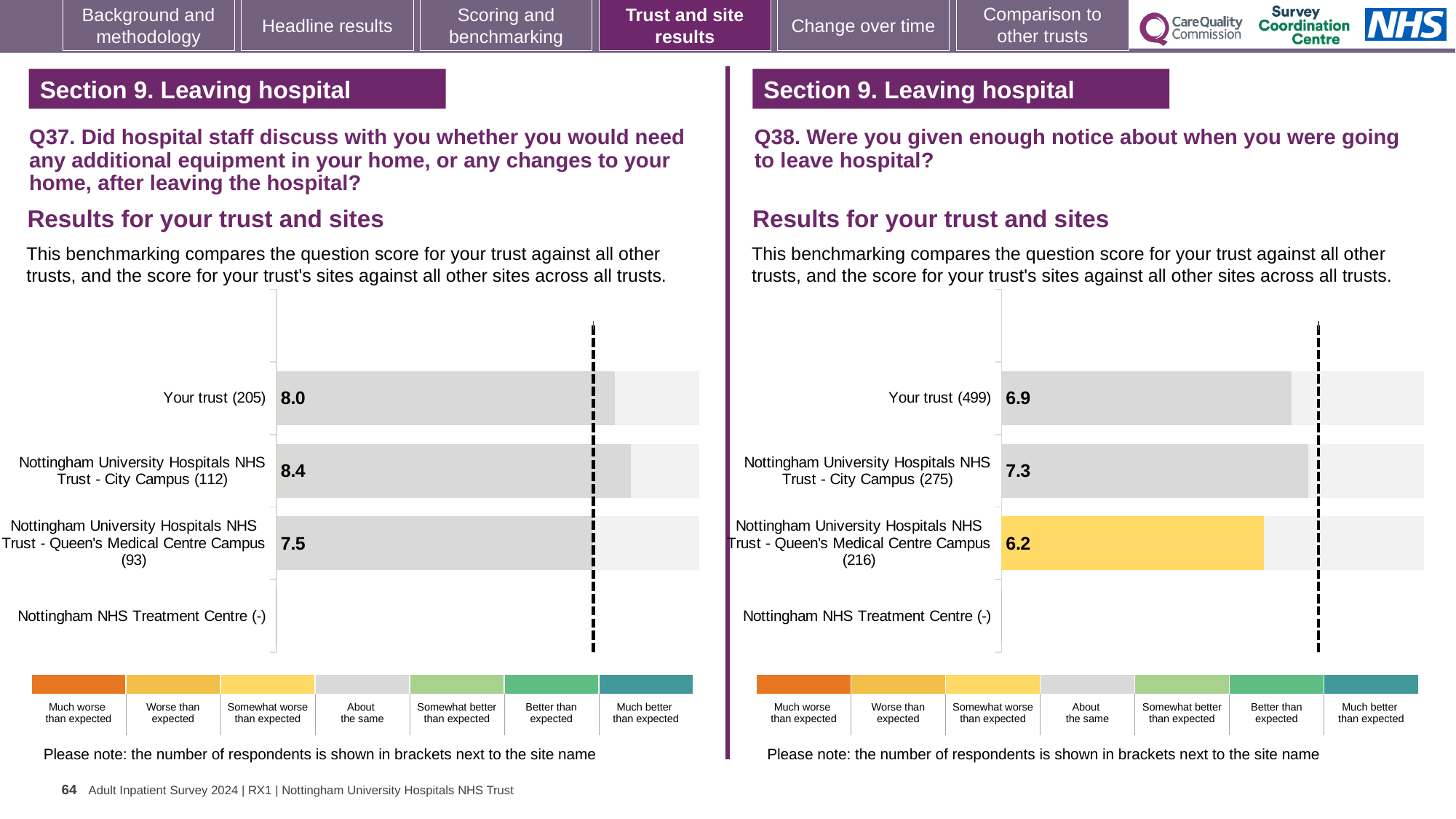
On the Q38 chart (right), which site or trust has the highest score shown? Nottingham University Hospitals NHS Trust - City Campus On the Q38 chart (right), which is larger: the score for Your trust or the score for City Campus? City Campus What kind of chart is used on the Q37 chart (left)? Bar chart On the Q37 chart (left), which site or trust has the lowest score shown? Nottingham University Hospitals NHS Trust - Queen's Medical Centre Campus On the Q37 chart (left), what is the difference between the City Campus score and the Queen's Medical Centre Campus score? 0.9 On the Q37 chart (left), what is the score for Nottingham University Hospitals NHS Trust - City Campus? 8.4 On the Q37 chart (left), what is the score for Your trust? 8.0 On the Q38 chart (right), what is the difference between the City Campus score and the Queen's Medical Centre Campus score? 1.1 On the Q38 chart (right), which benchmark category does the colour of the Queen's Medical Centre Campus bar correspond to? Somewhat worse than expected On the Q38 chart (right), what is the score for Your trust? 6.9 On the Q38 chart (right), what is the score for Nottingham University Hospitals NHS Trust - Queen's Medical Centre Campus? 6.2 How many respondents are shown in brackets for Your trust on the Q38 chart (right)? 499